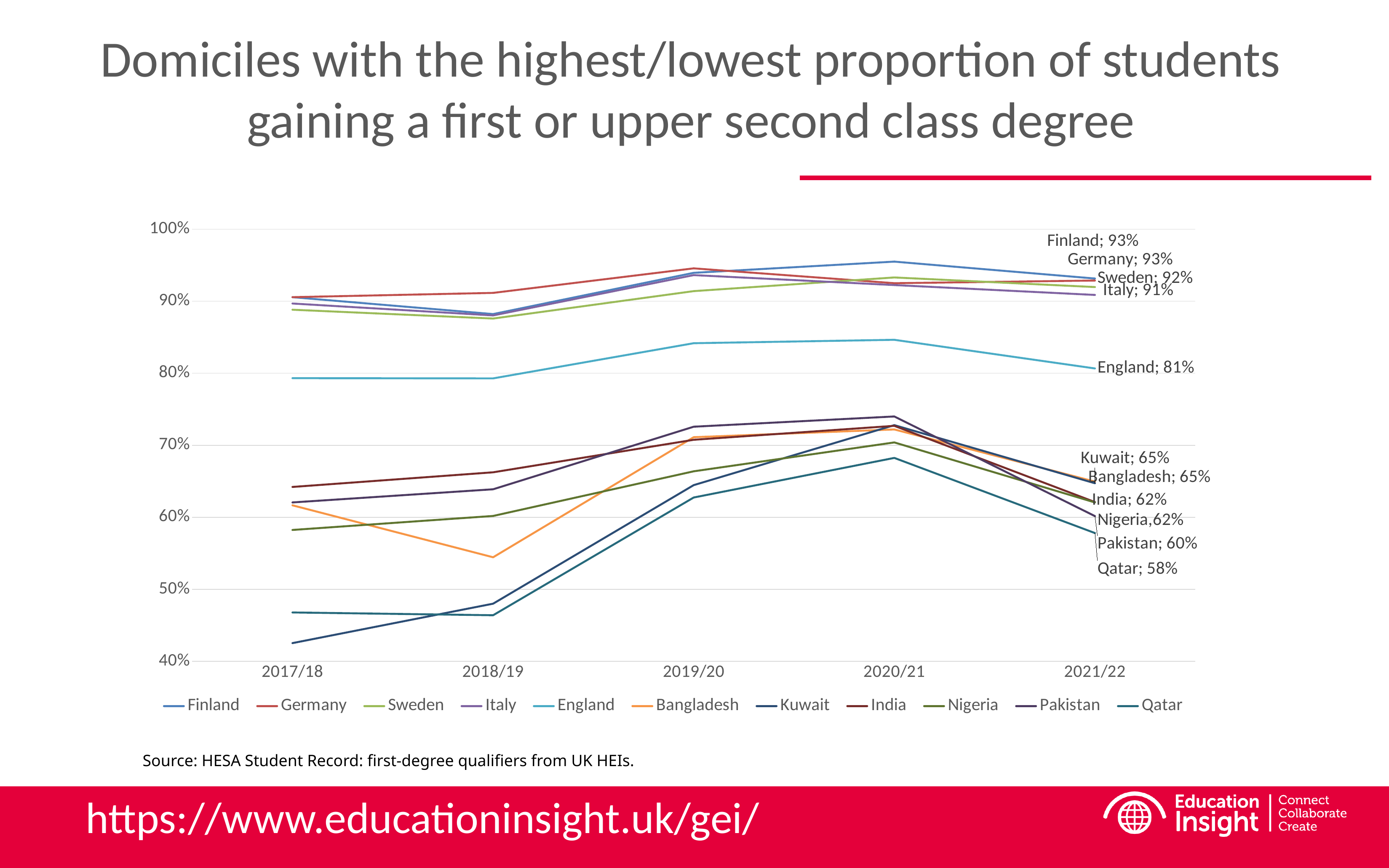
What is the value for Qatar in 2021/22? 58% What is the value for Pakistan in 2021/22? 60% Is the value for Kuwait in 2017/18 greater or less than 50%? less How many series does the legend list? 11 What is the title of the chart? Domiciles with the highest/lowest proportion of students gaining a first or upper second class degree In 2021/22, which is larger: the value for England or the value for Bangladesh? England What is the value for England in 2021/22? 81% What is the difference between Finland's and Qatar's values in 2021/22? 35 percentage points What type of chart is shown on the slide? line chart Does the value for Qatar rise or fall from 2020/21 to 2021/22? fall Which domicile has the lowest value in 2021/22? Qatar How many academic years are shown on the x axis? 5